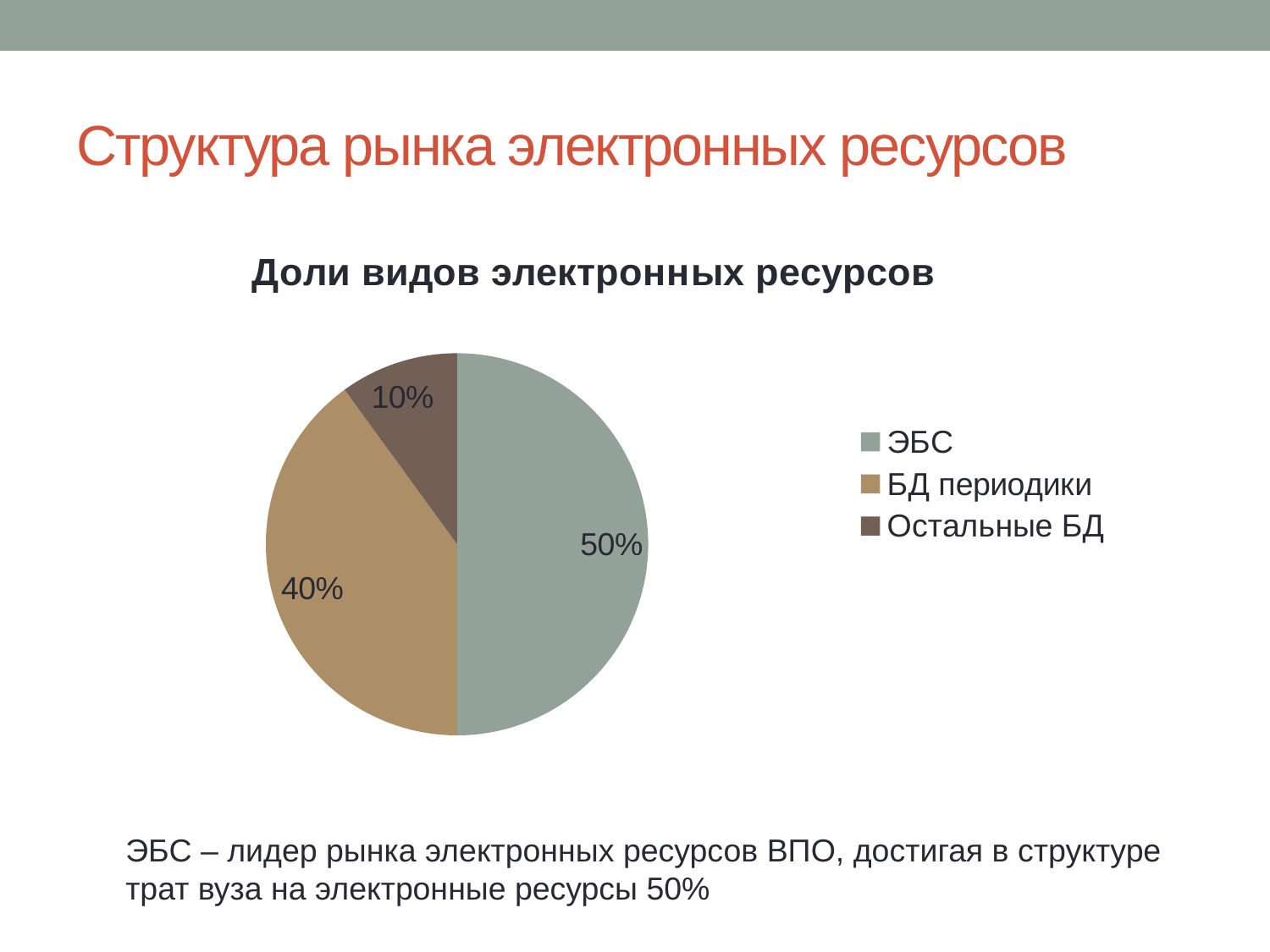
Which category has the smallest share of the pie? Остальные БД How many categories does the pie chart show? 3 Which category is shown in the darkest brown colour in the legend? Остальные БД What type of chart is shown on the slide? pie chart What is the difference in percentage points between the shares of БД периодики and Остальные БД? 30% What share of the pie does ЭБС have? 50% What is the difference in percentage points between the shares of ЭБС and БД периодики? 10% Which category has the largest share of the pie? ЭБС Which has a larger share, БД периодики or Остальные БД? БД периодики What share of the pie does БД периодики have? 40% What is the title of the chart? Доли видов электронных ресурсов What share of the pie does Остальные БД have? 10%